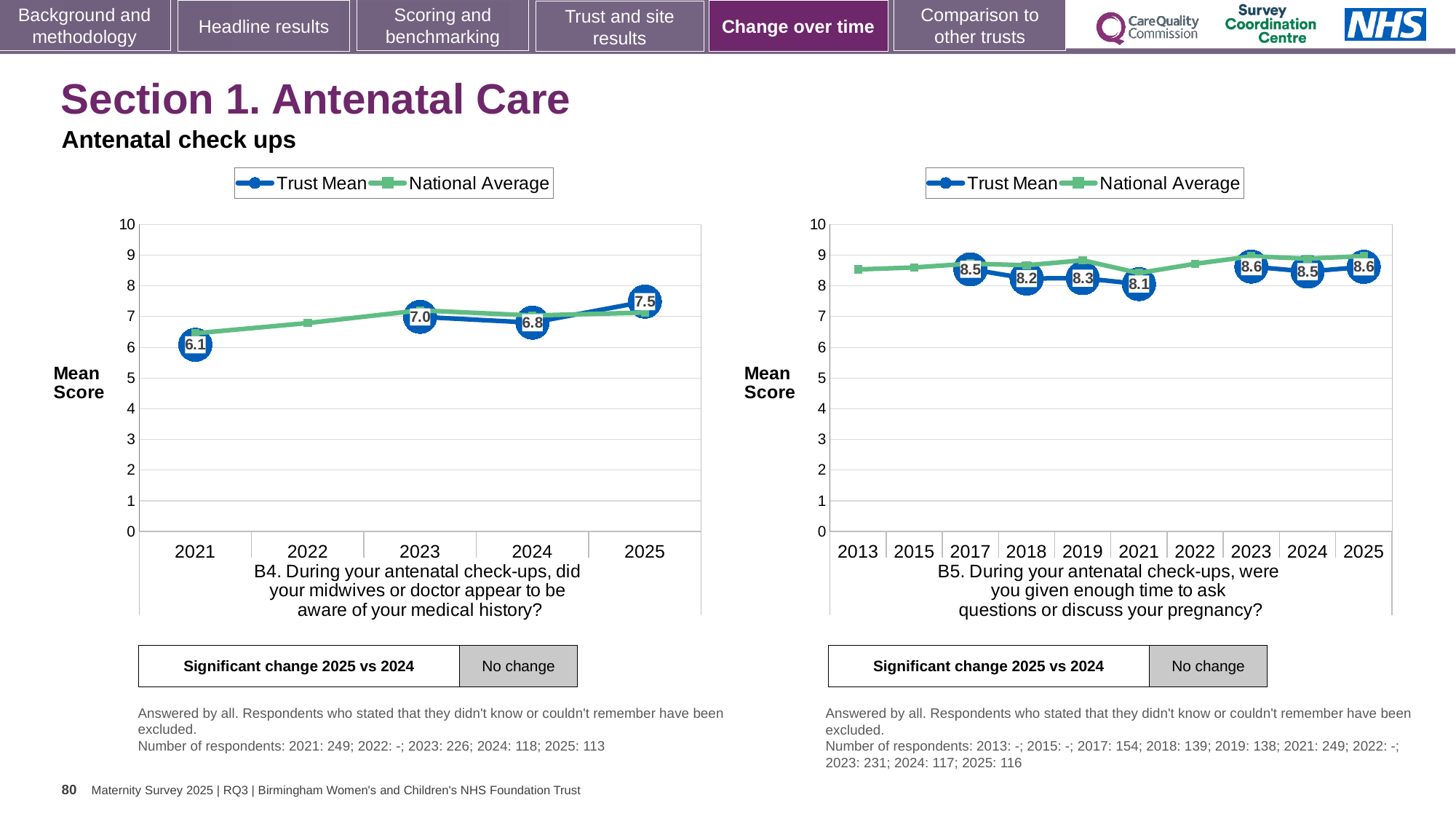
In the right chart (B5), what is the difference between the Trust Mean scores for 2025 and 2021? 0.5 How many years are shown on the x axis of the right chart (B5)? 10 In the left chart (B4), is the Trust Mean score for 2023 or 2024 larger? 2023 In the right chart (B5), which year has the lowest labelled Trust Mean score? 2021 In the left chart (B4), which year has the lowest labelled Trust Mean score? 2021 In the right chart (B5), what is the Trust Mean score for 2021? 8.1 In the left chart (B4), what is the Trust Mean score for 2025? 7.5 In the left chart (B4), which year has the highest labelled Trust Mean score? 2025 In the right chart (B5), what is the Trust Mean score for 2018? 8.2 In the left chart (B4), what is the difference between the Trust Mean scores for 2025 and 2021? 1.4 How many series does the legend of the left chart (B4) list? 2 In the left chart (B4), what is the Trust Mean score for 2021? 6.1